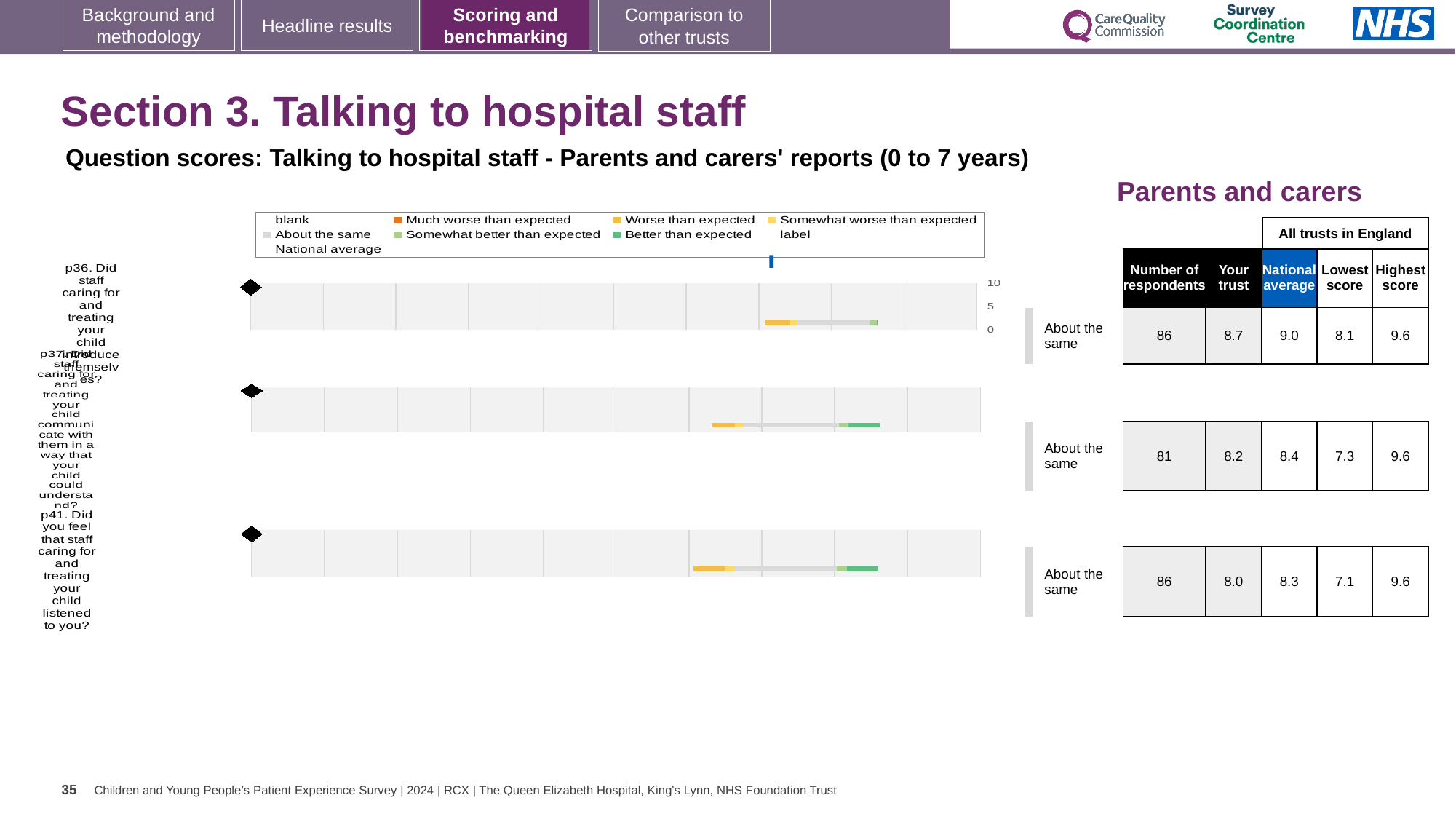
What benchmark category is shown for question p37? About the same How many respondents answered question p37? 81 What is the national average score for question p37 (Did staff communicate with your child in a way they could understand?)? 8.4 What is the lowest score across all trusts in England for question p36? 8.1 What is the maximum value shown on the score axis of the charts? 10 Which of the three questions has the highest 'Your trust' score? p36 For question p36, which is larger: the 'Your trust' score or the national average? National average What is the highest score across all trusts in England for question p41 (Did you feel that staff listened to you?)? 9.6 What kind of chart is used to show the question scores on this slide? Bar chart For question p41, what is the difference between the national average and the 'Your trust' score? 0.3 Which of the three questions has the lowest 'Your trust' score? p41 What is the 'Your trust' score for question p36 (Did staff caring for and treating your child introduce themselves?)? 8.7